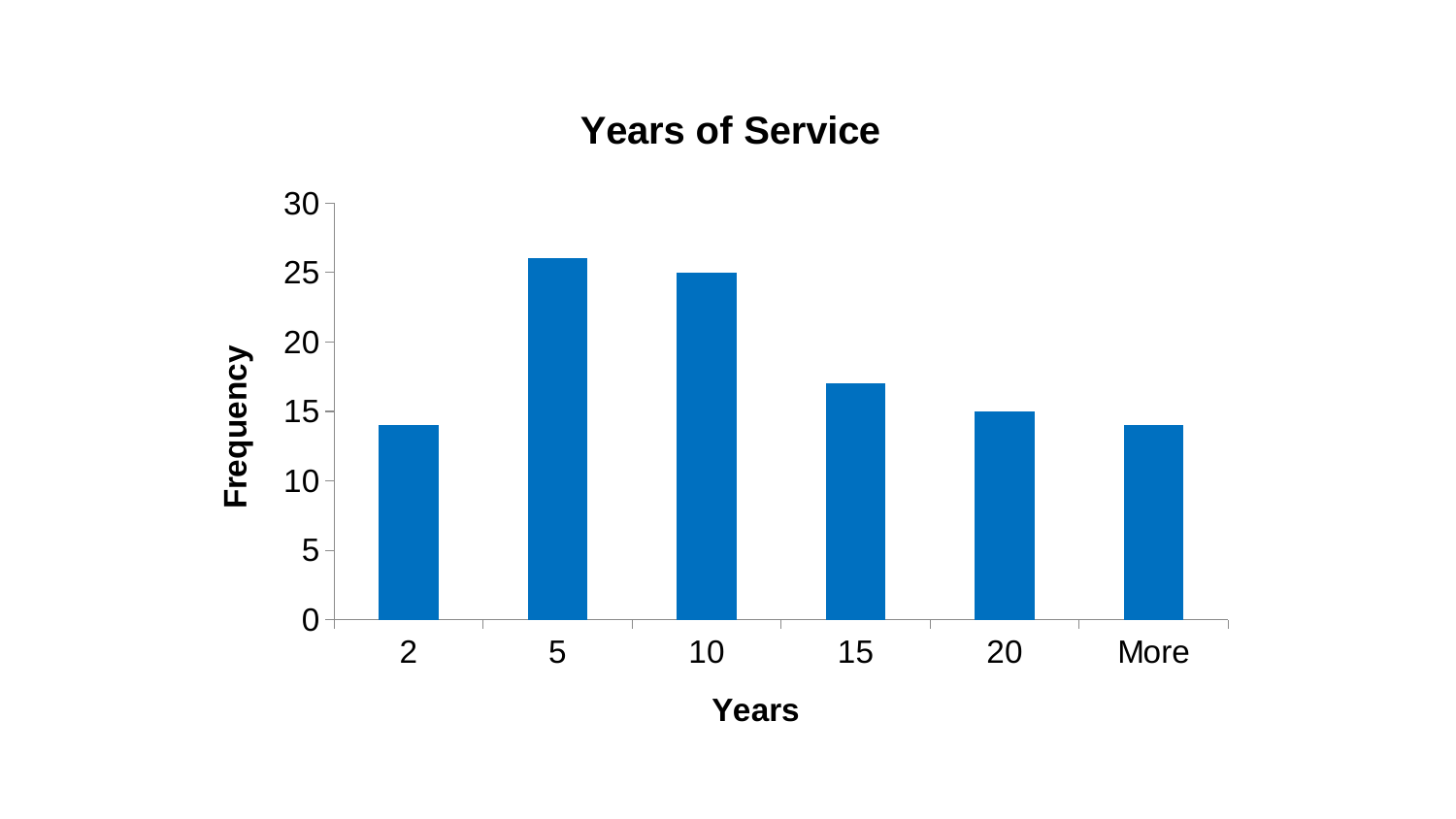
What is the label of the vertical axis? Frequency Is the frequency for 2 years greater or less than 15? less How many categories are shown on the x axis of the chart? 6 Is the frequency for 15 years greater or less than 15? greater Which has the higher frequency, 10 years or 20 years? 10 Which has the higher frequency, 5 years or 15 years? 5 What kind of chart is shown on the slide? bar chart Is the frequency for More greater or less than 15? less From the 5 years category to the More category, do the frequencies rise or fall? fall What is the title of the chart? Years of Service